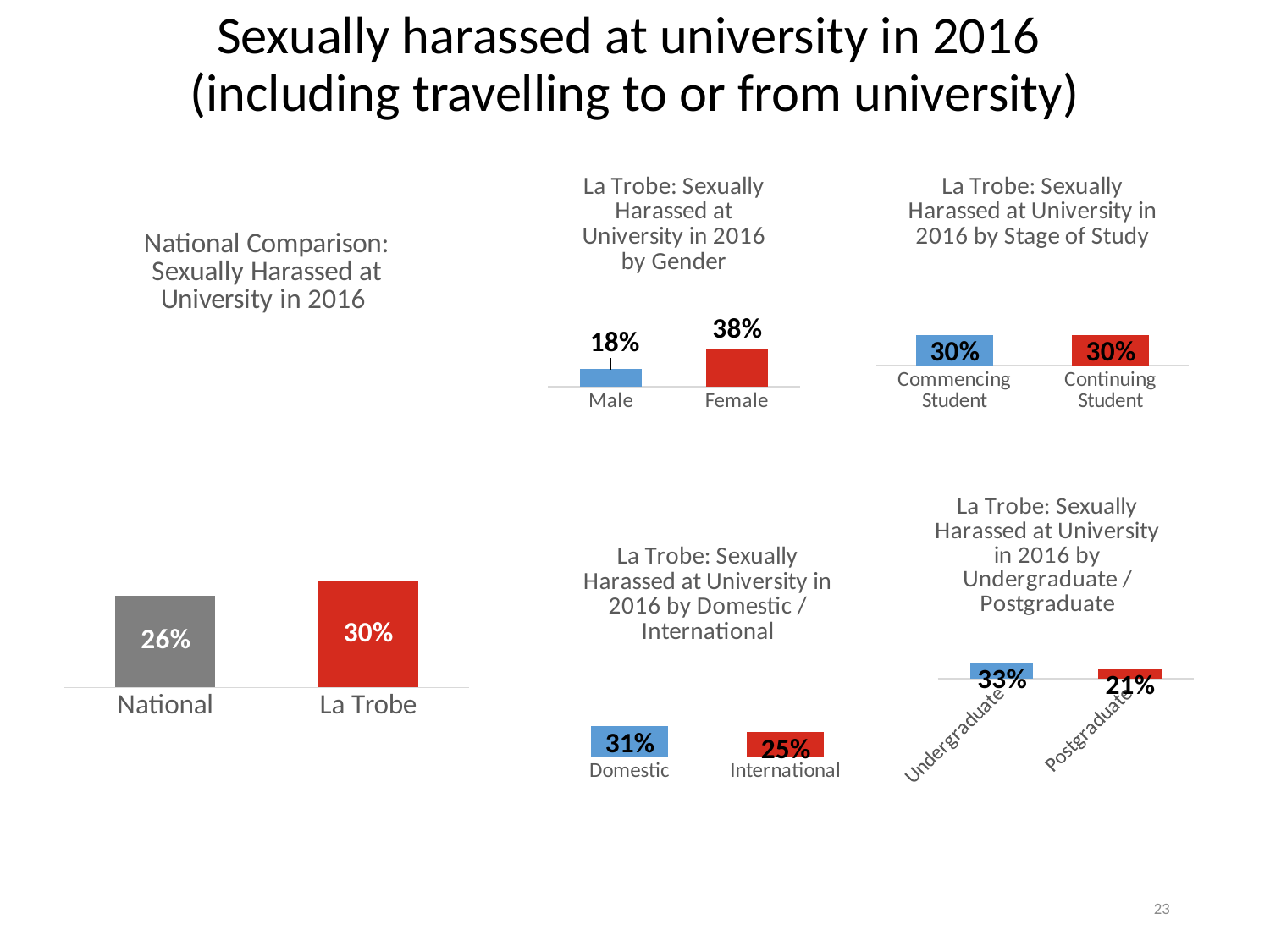
In the 'La Trobe: Sexually Harassed at University in 2016 by Domestic / International' chart, what is the value for International? 25% How many categories does the 'La Trobe: Sexually Harassed at University in 2016 by Gender' chart show? 2 In the 'National Comparison: Sexually Harassed at University in 2016' chart, what is the difference between the La Trobe and National values? 4% What type of chart is the 'National Comparison: Sexually Harassed at University in 2016' chart? Bar chart In the 'La Trobe: Sexually Harassed at University in 2016 by Undergraduate / Postgraduate' chart, what is the value for Postgraduate? 21% In the 'La Trobe: Sexually Harassed at University in 2016 by Gender' chart, what is the difference between the Female and Male values? 20% In the 'La Trobe: Sexually Harassed at University in 2016 by Stage of Study' chart, what is the value for Continuing Student? 30% In the 'La Trobe: Sexually Harassed at University in 2016 by Undergraduate / Postgraduate' chart, what is the difference between the Undergraduate and Postgraduate values? 12% In the 'La Trobe: Sexually Harassed at University in 2016 by Domestic / International' chart, which is larger, Domestic or International? Domestic In the 'National Comparison: Sexually Harassed at University in 2016' chart, what is the value for La Trobe? 30% In the 'La Trobe: Sexually Harassed at University in 2016 by Gender' chart, what is the value for Male? 18% In the 'La Trobe: Sexually Harassed at University in 2016 by Gender' chart, which category has the highest value? Female